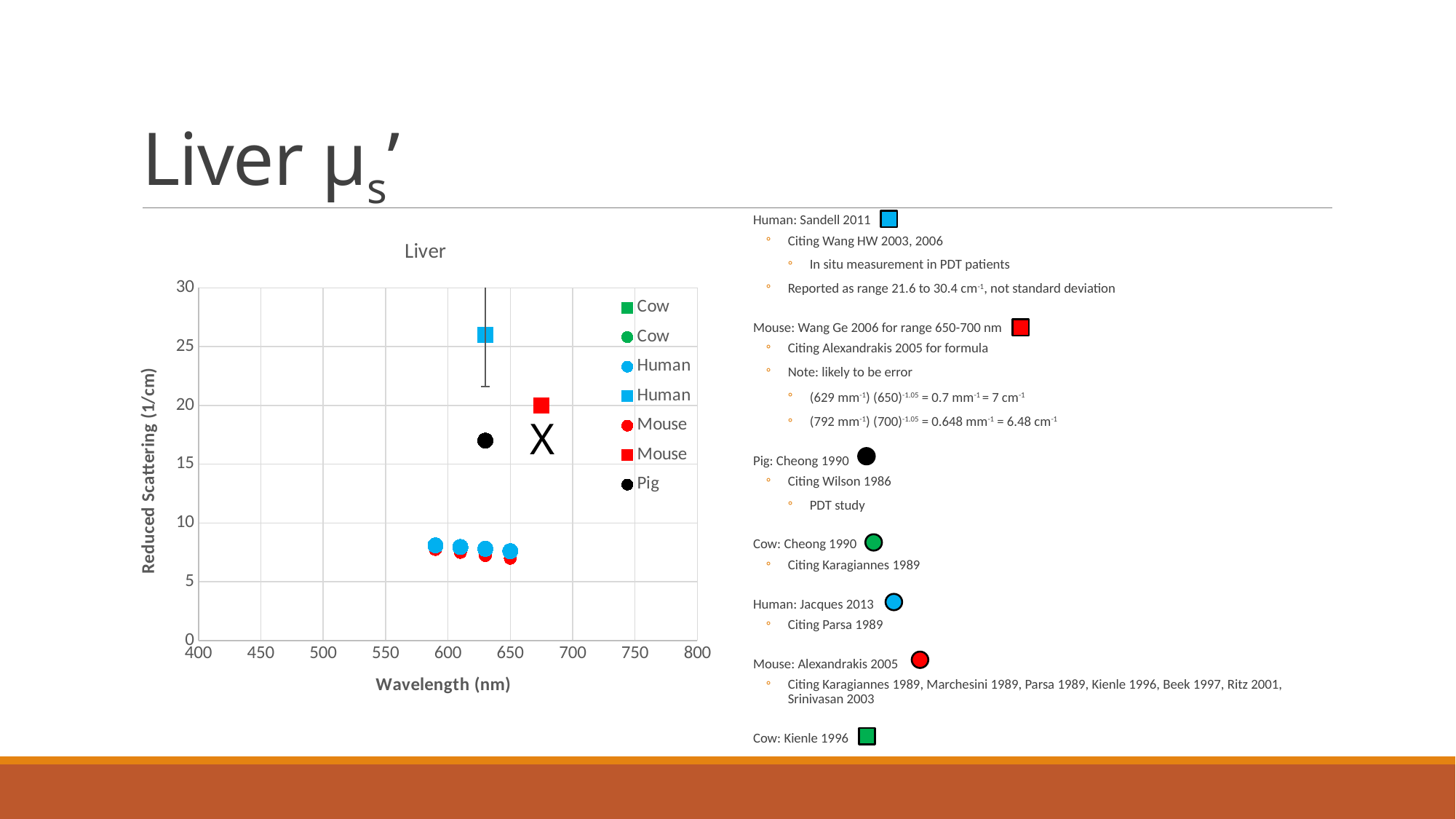
How many Human circle points are plotted on the chart? 4 Is the value for the Mouse square point (near 675 nm) greater or less than 25? less Are the values for the Human circle points greater or less than 10? less Which is larger, the value for the Human square point or the value for the Pig point? Human square point What is the label of the y axis of the chart? Reduced Scattering (1/cm) Which series has the highest plotted reduced scattering value? Human What kind of chart is shown on the slide? scatter chart How many series does the legend of the Liver chart list? 7 What is the title of the chart? Liver Is the value for the Human square point (near 630 nm) greater or less than 20? greater